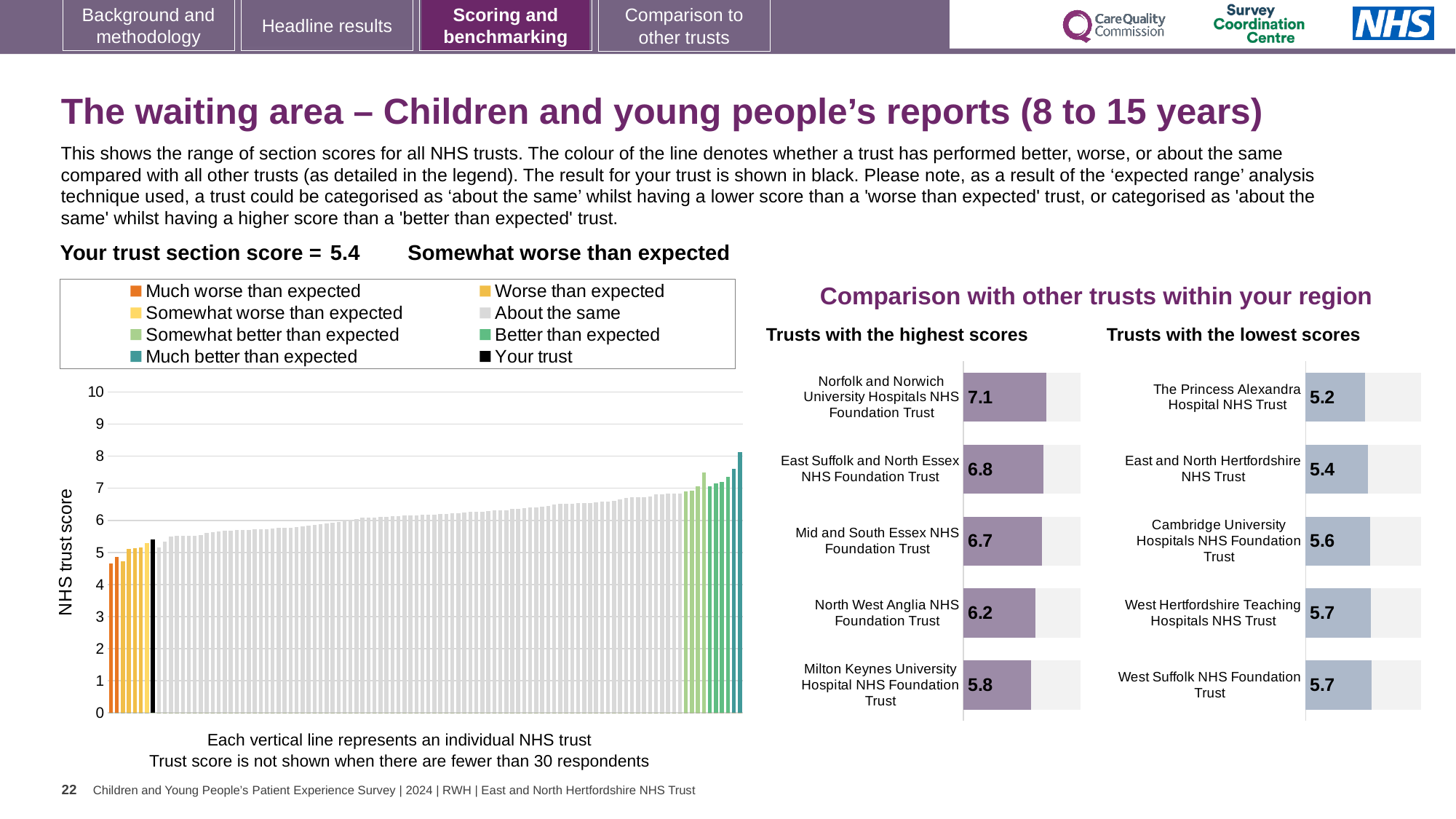
What is your trust's section score shown on the slide? 5.4 In the 'Trusts with the highest scores' chart, which has the larger score: East Suffolk and North Essex NHS Foundation Trust or Mid and South Essex NHS Foundation Trust? East Suffolk and North Essex NHS Foundation Trust How many entries does the legend of the 'NHS trust score' chart list? 8 In the 'Trusts with the lowest scores' chart, what is the score for The Princess Alexandra Hospital NHS Trust? 5.2 In the 'NHS trust score' chart on the left, do the bar values rise or fall from left to right? rise What kind of chart is the 'NHS trust score' chart on the left of the slide? bar chart How many trusts are shown in the 'Trusts with the highest scores' chart? 5 In the 'Trusts with the lowest scores' chart, what is the difference between the scores of Cambridge University Hospitals NHS Foundation Trust and East and North Hertfordshire NHS Trust? 0.2 In the 'Trusts with the highest scores' chart, what is the difference between the scores of Norfolk and Norwich University Hospitals NHS Foundation Trust and Milton Keynes University Hospital NHS Foundation Trust? 1.3 In the 'Trusts with the highest scores' chart, what is the score for Norfolk and Norwich University Hospitals NHS Foundation Trust? 7.1 In the 'Trusts with the lowest scores' chart, which trust has the lowest score? The Princess Alexandra Hospital NHS Trust In the 'Trusts with the highest scores' chart, which trust has the highest score? Norfolk and Norwich University Hospitals NHS Foundation Trust